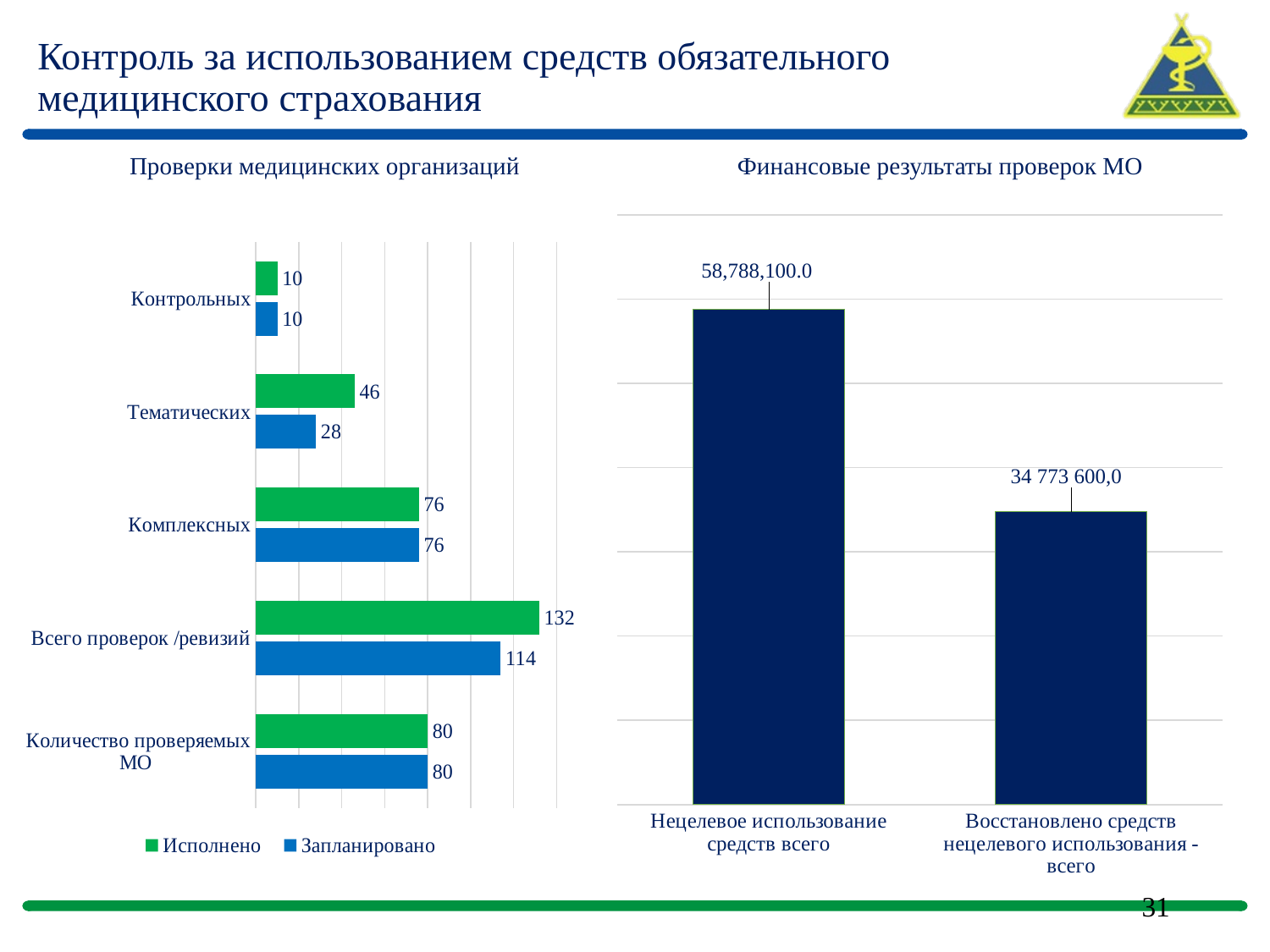
In the chart 'Финансовые результаты проверок МО', what is the value for Восстановлено средств нецелевого использования - всего? 34 773 600,0 In the chart 'Проверки медицинских организаций', what is the value of Запланировано for Всего проверок /ревизий? 114 In the chart 'Проверки медицинских организаций', what is the value of Исполнено for Тематических? 46 In the chart 'Проверки медицинских организаций', how many series does the legend list? 2 In the chart 'Проверки медицинских организаций', what is the value of Запланировано for Тематических? 28 In the chart 'Проверки медицинских организаций', what is the difference between Исполнено and Запланировано for Всего проверок /ревизий? 18 In the chart 'Финансовые результаты проверок МО', what is the value for Нецелевое использование средств всего? 58,788,100.0 What kind of chart is 'Финансовые результаты проверок МО'? Bar chart In the chart 'Проверки медицинских организаций', how many categories are shown? 5 In the chart 'Проверки медицинских организаций', which is larger for Тематических: Исполнено or Запланировано? Исполнено In the chart 'Проверки медицинских организаций', which category has the highest Исполнено value? Всего проверок /ревизий In the chart 'Проверки медицинских организаций', which category has the lowest Запланировано value? Контрольных